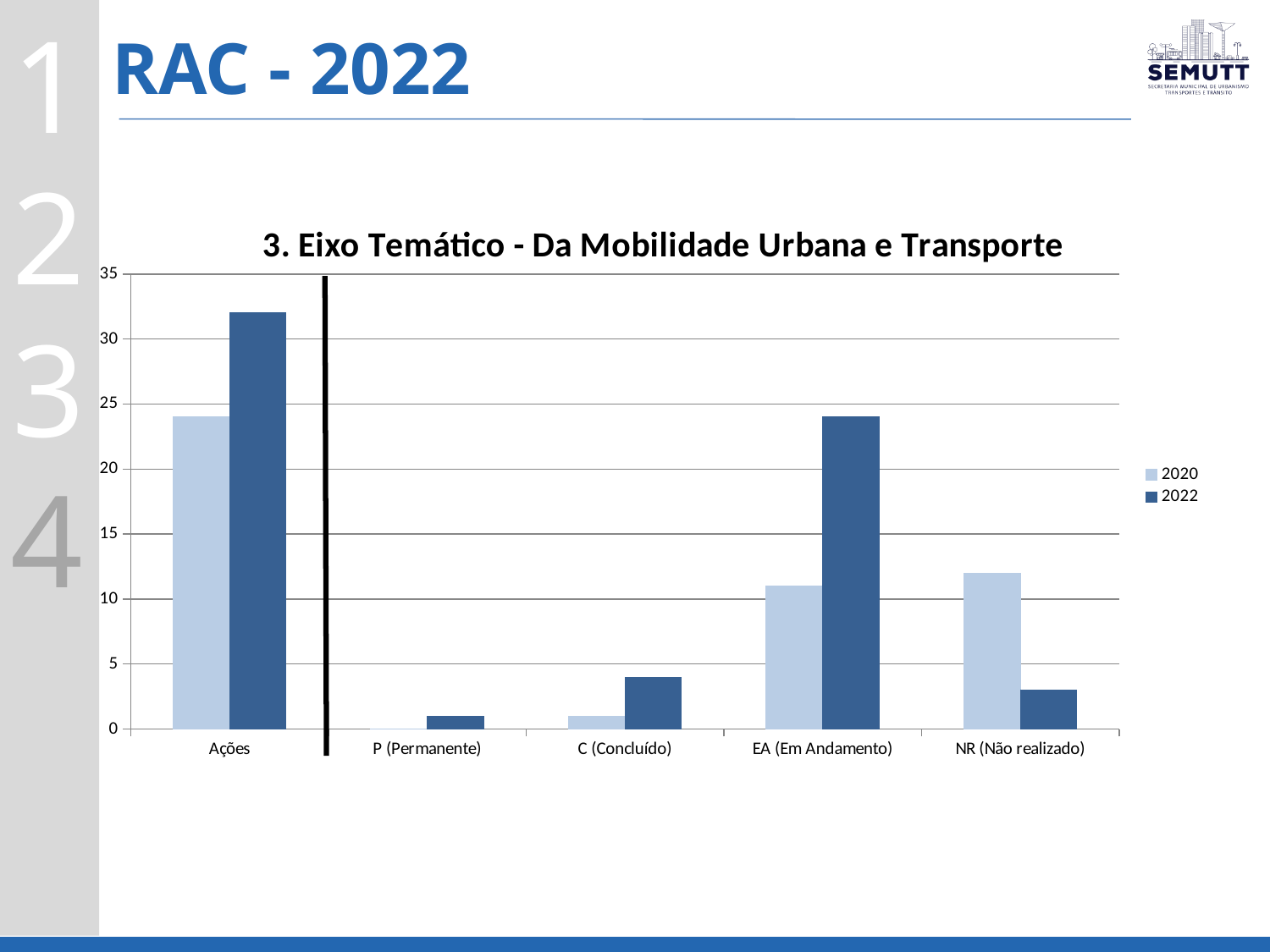
How many series does the legend list? 2 What kind of chart is shown on the slide? bar chart Which category has the highest value for the 2022 series? Ações For NR (Não realizado), which series has the larger value, 2020 or 2022? 2020 Is the 2022 value for NR (Não realizado) greater or less than 5? less Is the 2022 value for EA (Em Andamento) greater or less than 20? greater Which category has the lowest value for the 2020 series? P (Permanente) Is the 2022 value for Ações greater or less than 30? greater Which category has the lowest value for the 2022 series? P (Permanente) For EA (Em Andamento), which series has the larger value, 2020 or 2022? 2022 How many categories are shown on the x axis? 5 What is the title of the chart? 3. Eixo Temático - Da Mobilidade Urbana e Transporte